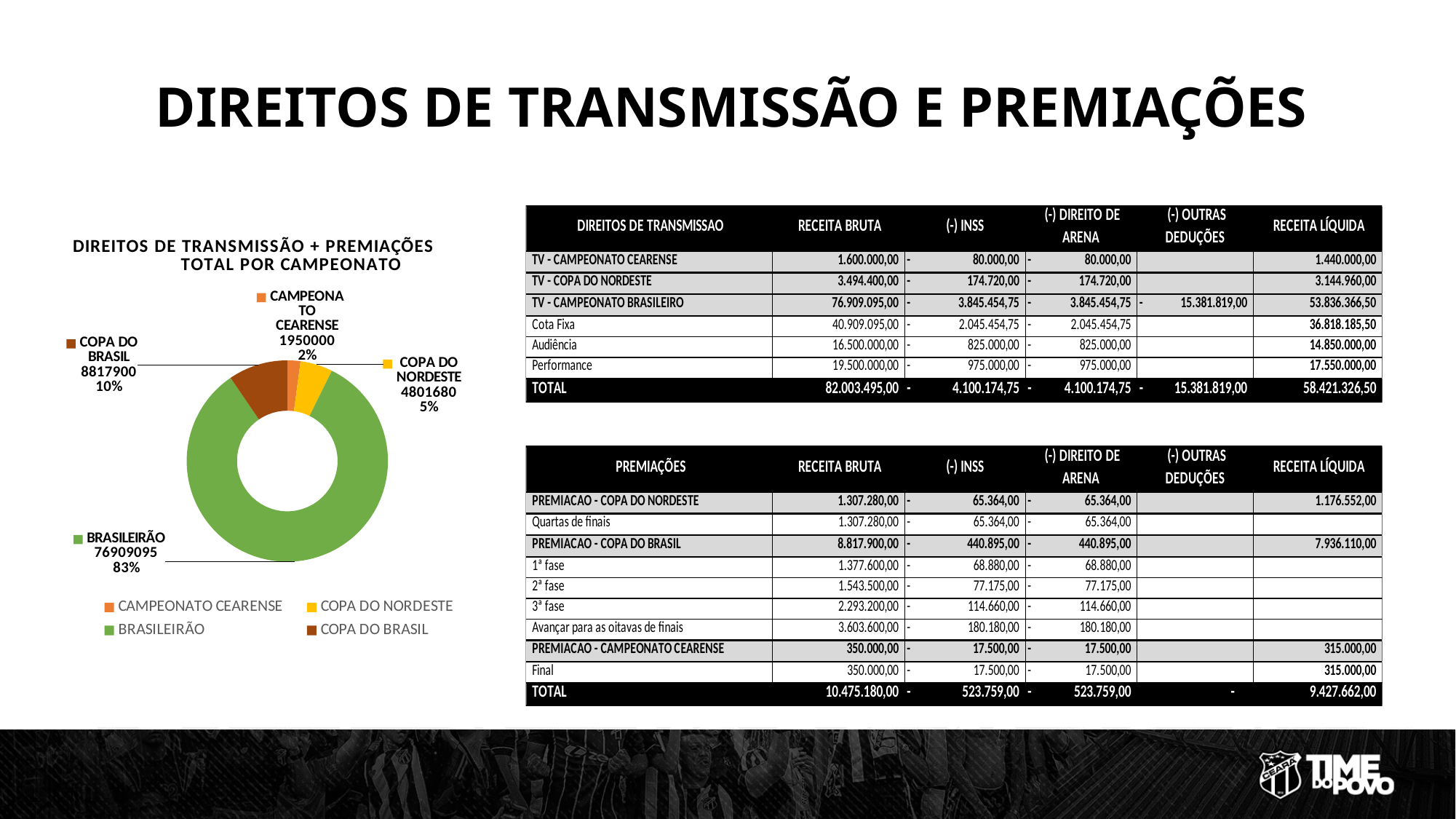
Which category has the largest share of the chart? BRASILEIRÃO How many categories does the chart show? 4 Which is larger in the chart, COPA DO BRASIL or COPA DO NORDESTE? COPA DO BRASIL What percentage share of the chart does COPA DO BRASIL have? 10% What is the value shown for CAMPEONATO CEARENSE in the chart? 1950000 Which category has the smallest share of the chart? CAMPEONATO CEARENSE What percentage share of the chart does COPA DO NORDESTE have? 5% What kind of chart is shown on the slide? Donut (pie) chart What is the value shown for BRASILEIRÃO in the chart? 76909095 What is the title of the chart on the slide? DIREITOS DE TRANSMISSÃO + PREMIAÇÕES TOTAL POR CAMPEONATO What is the value shown for COPA DO BRASIL in the chart? 8817900 What is the value shown for COPA DO NORDESTE in the chart? 4801680